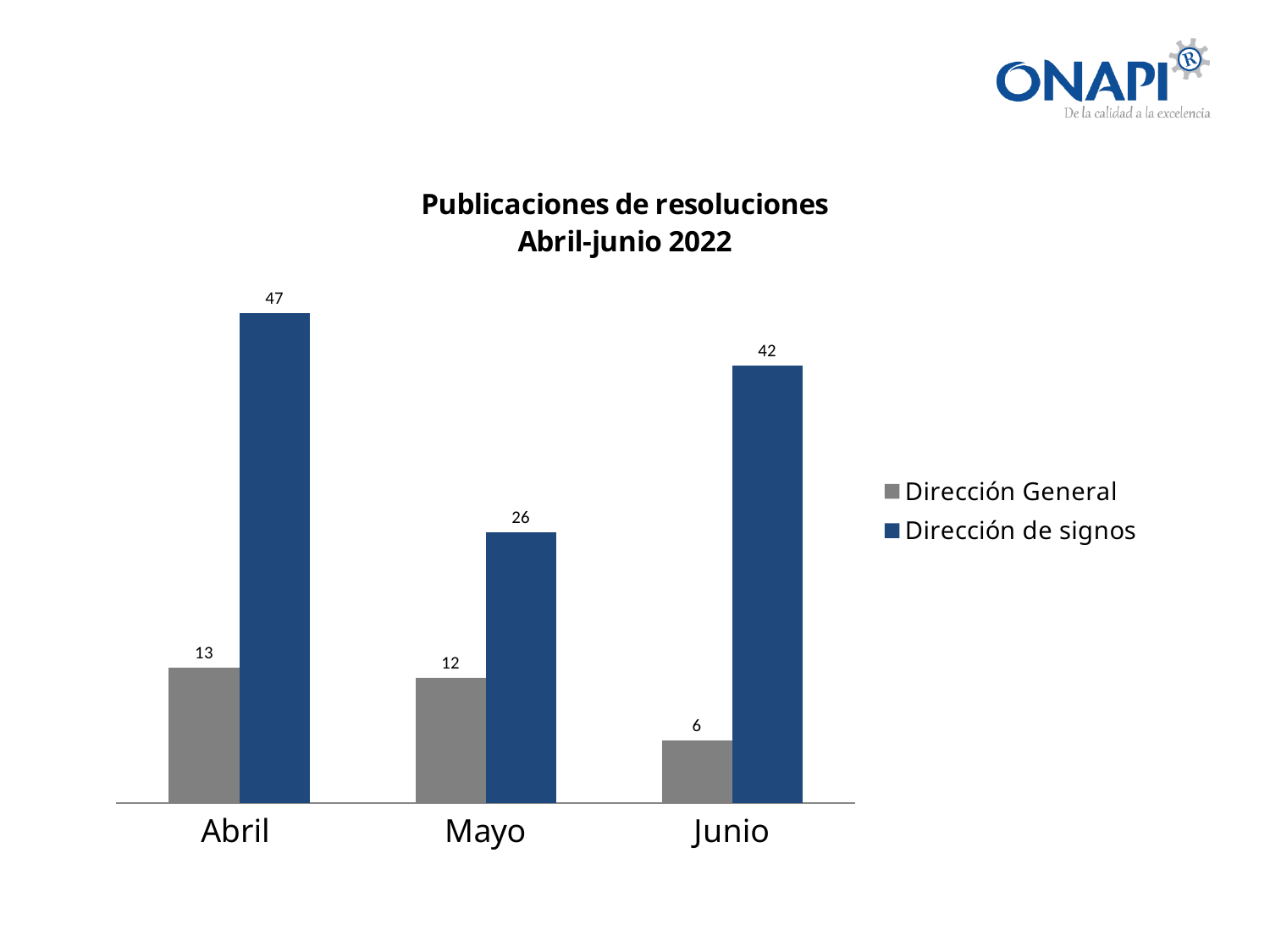
Which is larger: Dirección de signos in Mayo or Dirección de signos in Junio? Dirección de signos in Junio Which month has the lowest value for Dirección General? Junio How many series does the legend list? 2 What is the difference between the Dirección de signos values for Abril and Mayo? 21 Which month has the highest value for Dirección de signos? Abril What is the value for Dirección de signos in Abril? 47 What is the value for Dirección General in Mayo? 12 What is the value for Dirección General in Junio? 6 What kind of chart is shown on the slide? Bar chart What is the difference between Dirección de signos and Dirección General in Junio? 36 How many months are shown on the x axis? 3 What is the title of the chart? Publicaciones de resoluciones Abril-junio 2022